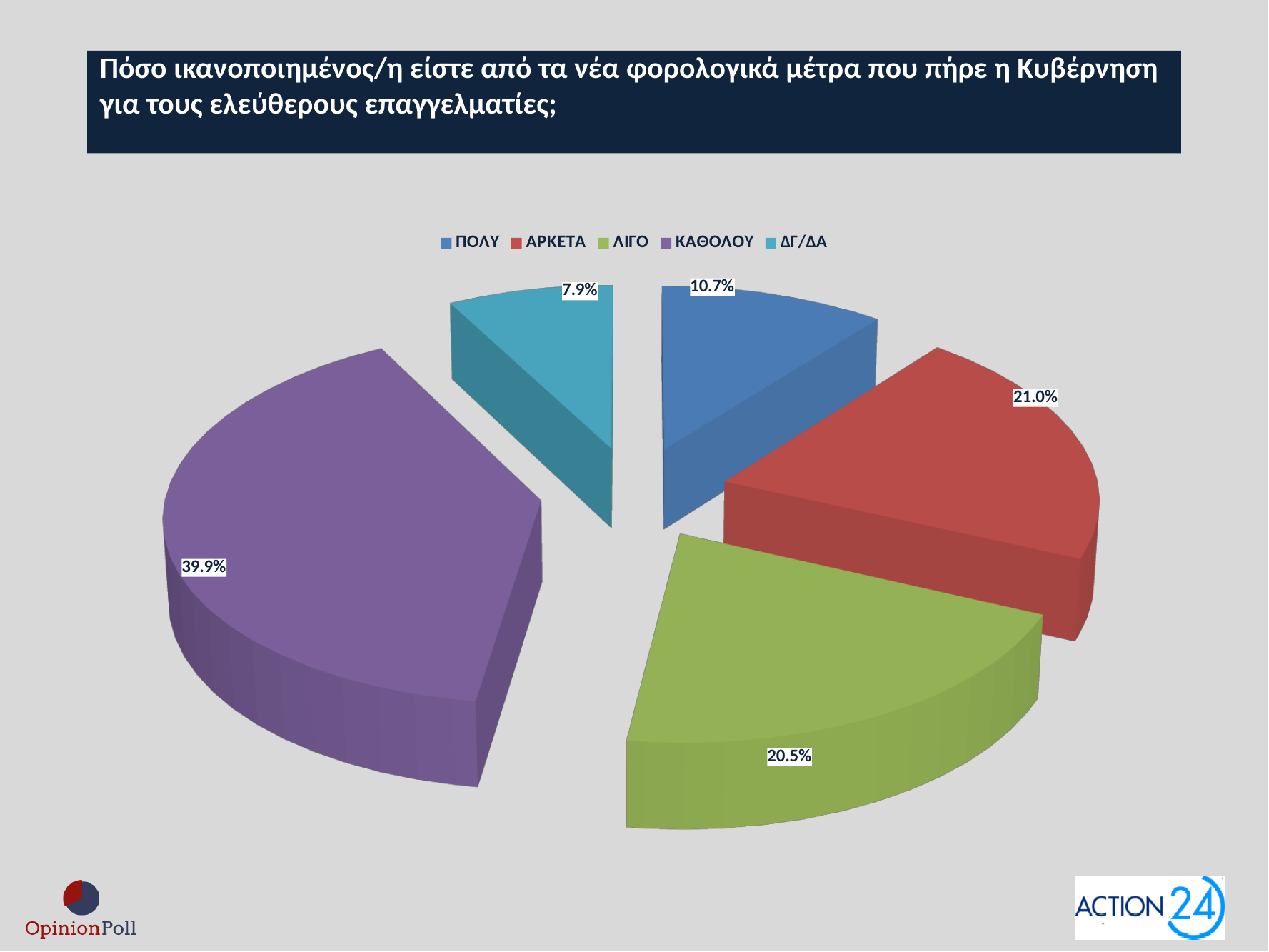
What type of chart is shown on the slide? Pie chart Which response category has the largest share of the pie? ΚΑΘΟΛΟΥ Which response category has the smallest share of the pie? ΔΓ/ΔΑ What is the value shown for ΔΓ/ΔΑ? 7.9% How many categories does the pie chart show? 5 What percentage of respondents answered ΚΑΘΟΛΟΥ? 39.9% Which is larger, the share for ΠΟΛΥ or the share for ΚΑΘΟΛΟΥ? ΚΑΘΟΛΟΥ What colour is the slice for ΛΙΓΟ? Green What is the difference in percentage points between ΚΑΘΟΛΟΥ and ΛΙΓΟ? 19.4 What percentage of respondents answered ΠΟΛΥ? 10.7% What is the difference in percentage points between ΑΡΚΕΤΑ and ΛΙΓΟ? 0.5 What is the value shown for ΑΡΚΕΤΑ? 21.0%